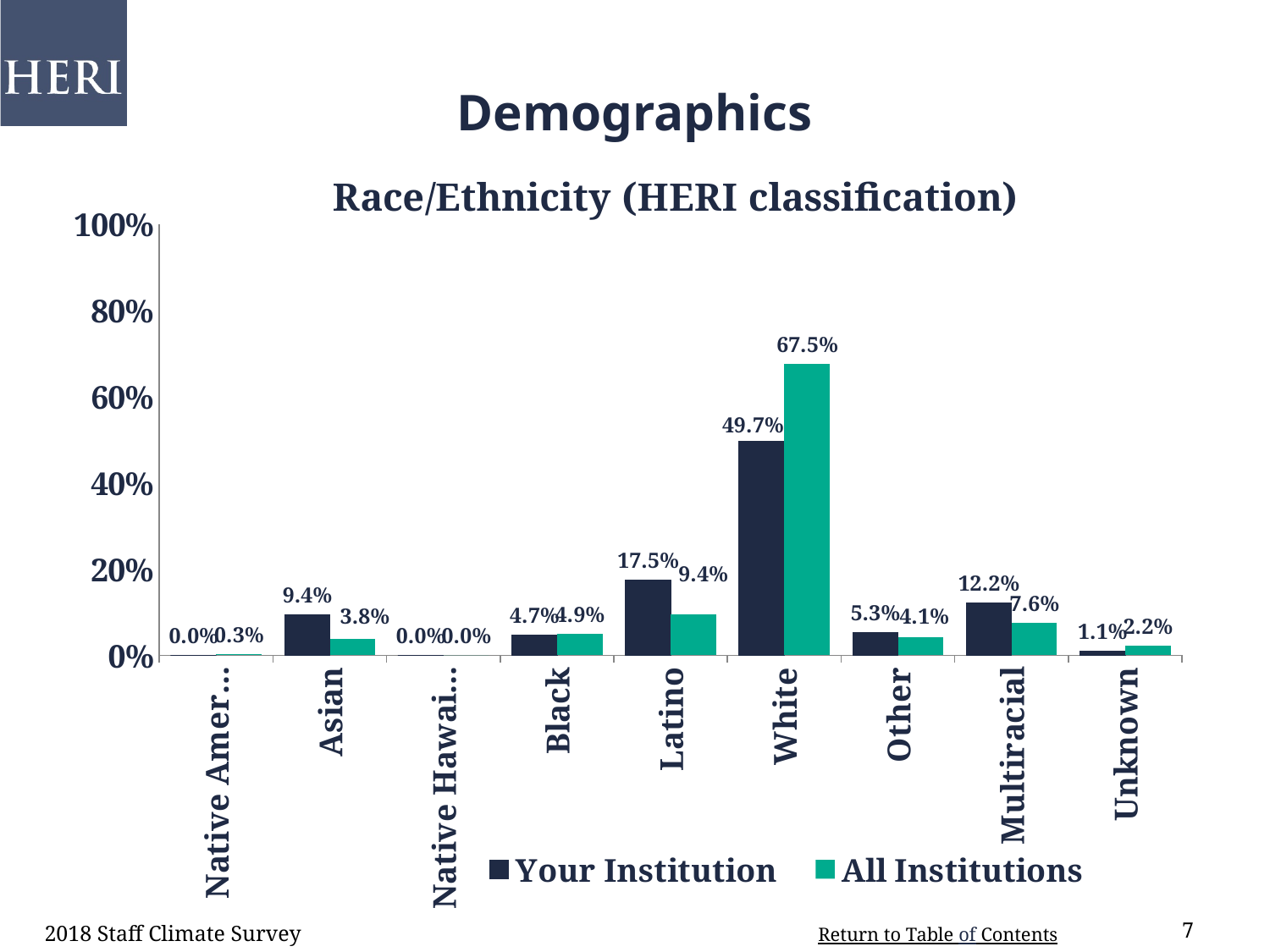
What is the value for White in the Your Institution series? 49.7% What is the value for Asian in the All Institutions series? 3.8% Which is larger for Asian: the Your Institution value or the All Institutions value? Your Institution What is the difference between the All Institutions and Your Institution values for White? 17.8% What is the value for Latino in the Your Institution series? 17.5% What is the value for Multiracial in the Your Institution series? 12.2% How many series does the legend list? 2 What is the difference between the Your Institution and All Institutions values for Latino? 8.1% Is the value for White in the All Institutions series greater or less than 60%? greater What kind of chart is shown on the slide? Bar chart What is the value for White in the All Institutions series? 67.5% Which category has the highest value in the All Institutions series? White